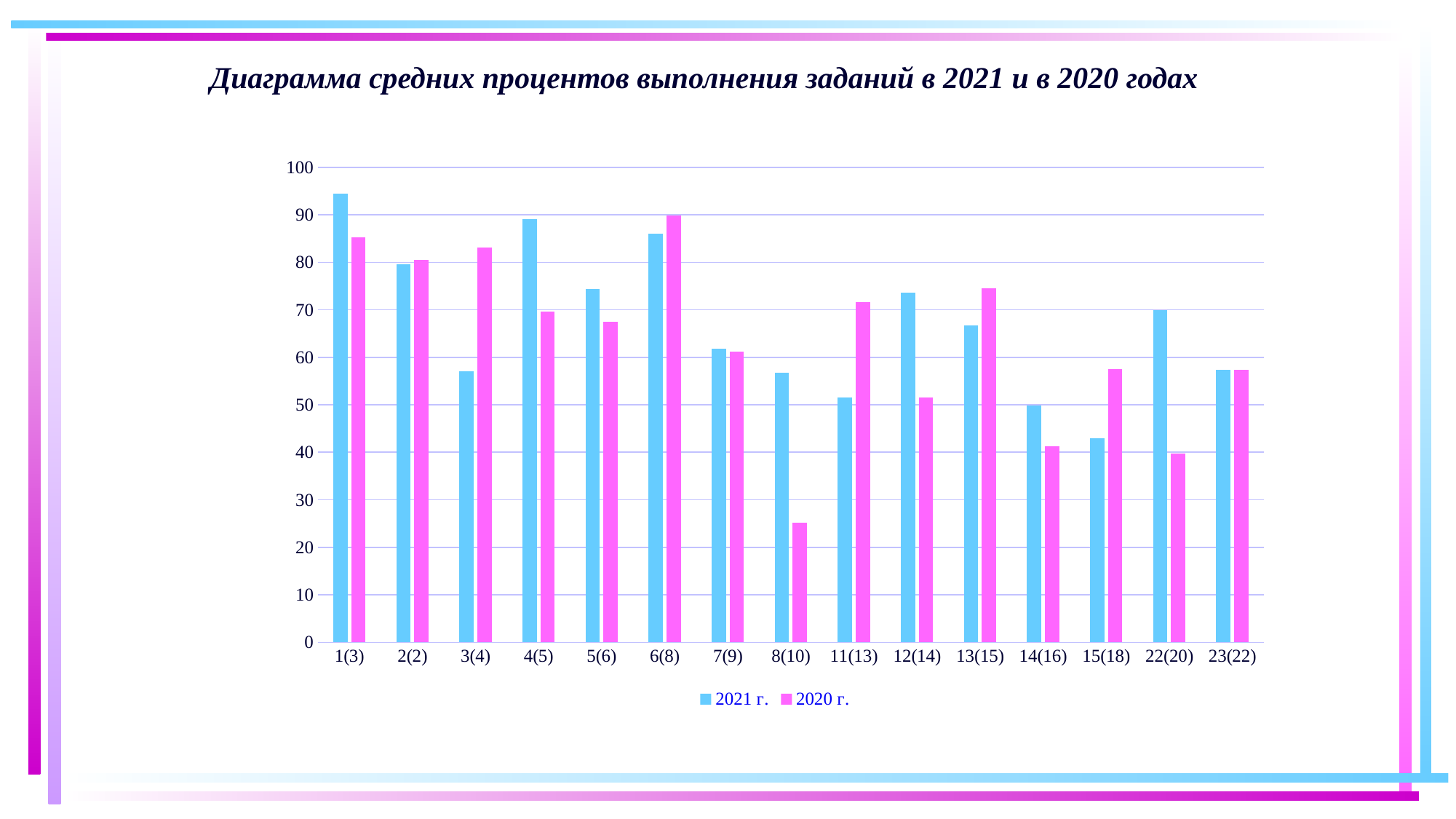
For category 3(4), which series has the larger value, 2021 г. or 2020 г.? 2020 г. How many categories are shown on the x axis? 15 Is the 2021 г. value for 1(3) greater or less than 90? greater For category 22(20), which series has the larger value, 2021 г. or 2020 г.? 2021 г. Which category has the lowest value for the 2020 г. series? 8(10) What kind of chart is shown on the slide? bar chart Is the 2021 г. value for 4(5) greater or less than 80? greater Is the 2020 г. value for 8(10) greater or less than 30? less Which category has the highest value for the 2021 г. series? 1(3) Which category has the lowest value for the 2021 г. series? 15(18) Which category has the highest value for the 2020 г. series? 6(8) How many series does the legend list? 2